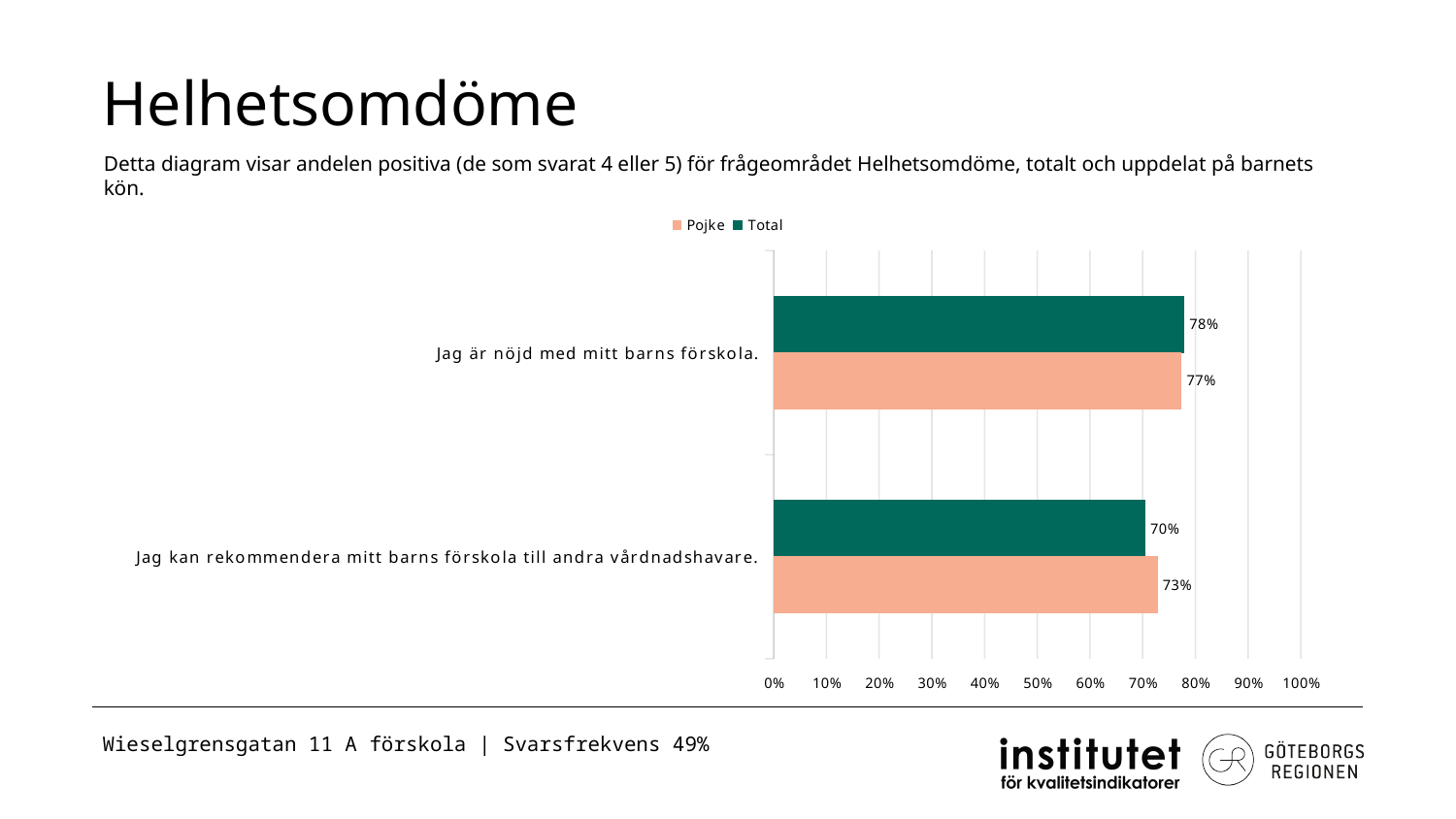
What is the Total value for "Jag kan rekommendera mitt barns förskola till andra vårdnadshavare."? 70% What is the difference between the Pojke and Total values for "Jag kan rekommendera mitt barns förskola till andra vårdnadshavare."? 3% What is the Pojke value for "Jag kan rekommendera mitt barns förskola till andra vårdnadshavare."? 73% Is the Total value for "Jag är nöjd med mitt barns förskola." greater or less than 70%? greater What is the Pojke value for "Jag är nöjd med mitt barns förskola."? 77% For "Jag kan rekommendera mitt barns förskola till andra vårdnadshavare.", which is larger, the Pojke value or the Total value? Pojke Which category has the highest Total value? Jag är nöjd med mitt barns förskola. Which category has the lowest Pojke value? Jag kan rekommendera mitt barns förskola till andra vårdnadshavare. How many series does the legend list? 2 What kind of chart is shown on the slide? Bar chart What is the Total value for "Jag är nöjd med mitt barns förskola."? 78% How many categories are shown in the chart? 2